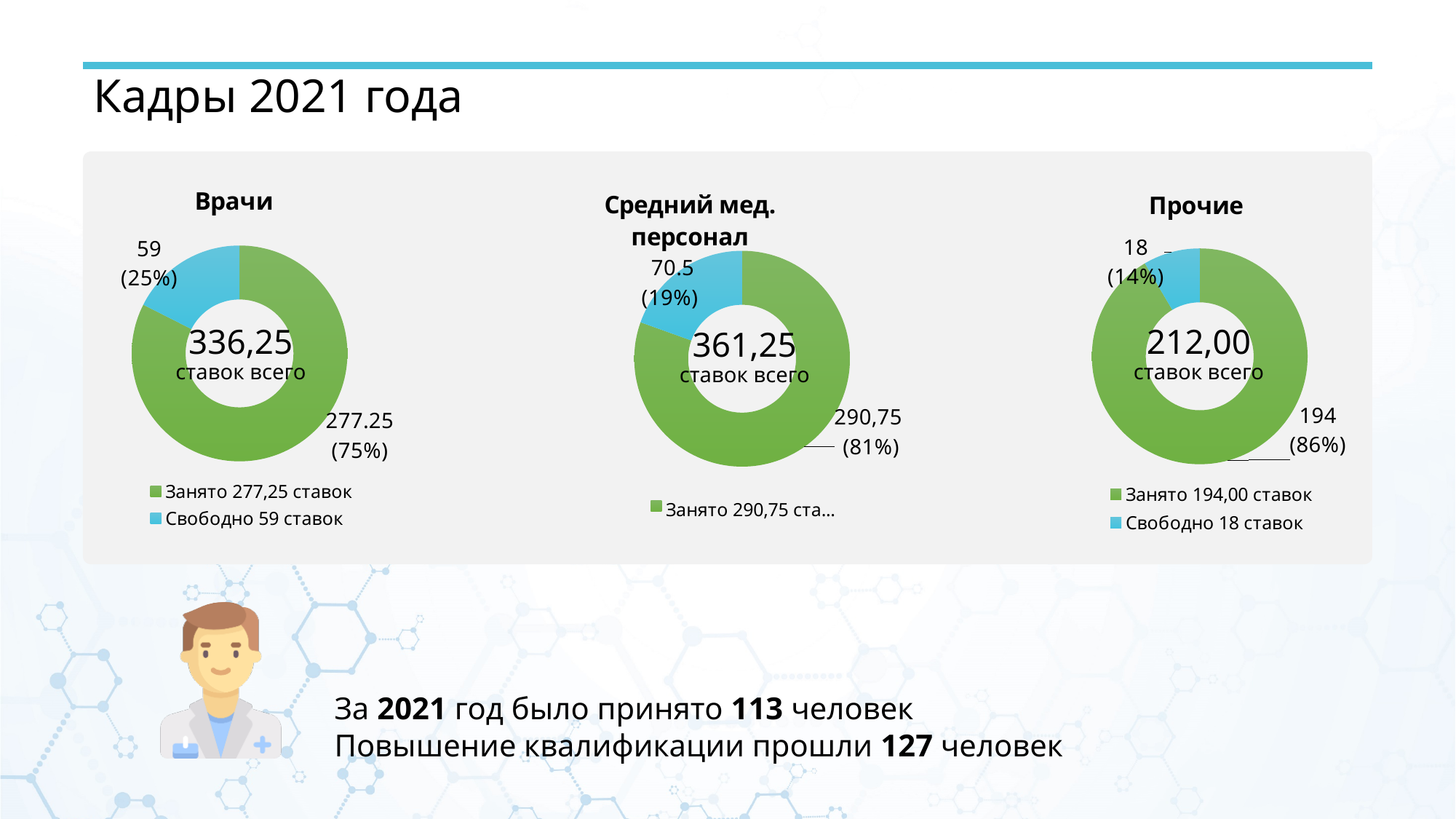
What total number of positions (ставок всего) is shown in the centre of the "Средний мед. персонал" chart? 361,25 In the "Прочие" chart, which slice is larger, "Занято" or "Свободно"? Занято In the "Средний мед. персонал" chart, what value is shown for the free (blue) slice? 70.5 In the "Врачи" chart, what value is shown for the "Свободно" slice? 59 In the "Врачи" chart, what percentage share does the "Занято" slice have? 75% In the "Прочие" chart, what value is shown for the "Занято" slice? 194 In the "Врачи" chart, what colour is the "Свободно" slice? Blue In the "Средний мед. персонал" chart, what percentage share does the occupied (green) slice have? 81% How many slices does the "Врачи" chart have? 2 In the "Прочие" chart, what percentage share does the "Свободно" slice have? 14% What type of chart is used for the "Врачи" chart? Doughnut (pie) chart In the "Прочие" chart, what is the difference between the "Занято" and "Свободно" values? 176